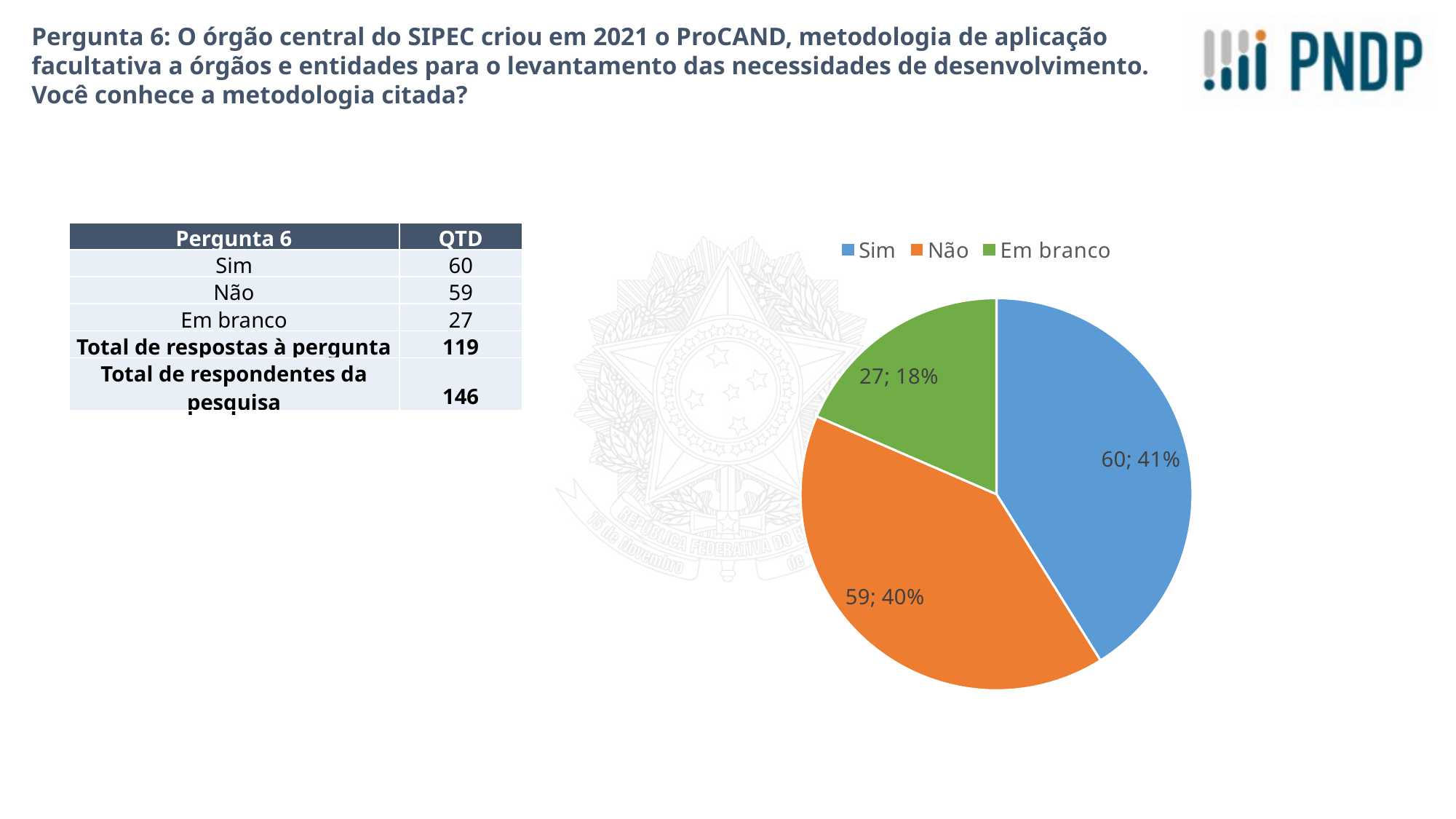
Which slice of the pie chart has the largest value? Sim How many entries does the legend of the pie chart list? 3 What percentage share of the pie does the "Em branco" slice represent? 18% What is the value shown for the "Em branco" slice of the pie chart? 27 Which colour is used for the "Não" slice in the pie chart? orange Which slice of the pie chart has the smallest value? Em branco What is the value shown for the "Não" slice of the pie chart? 59 What is the value shown for the "Sim" slice of the pie chart? 60 What percentage share of the pie does the "Sim" slice represent? 41% What kind of chart is shown on the slide? pie chart What is the difference between the values of the "Sim" and "Em branco" slices? 33 How many slices does the pie chart have? 3